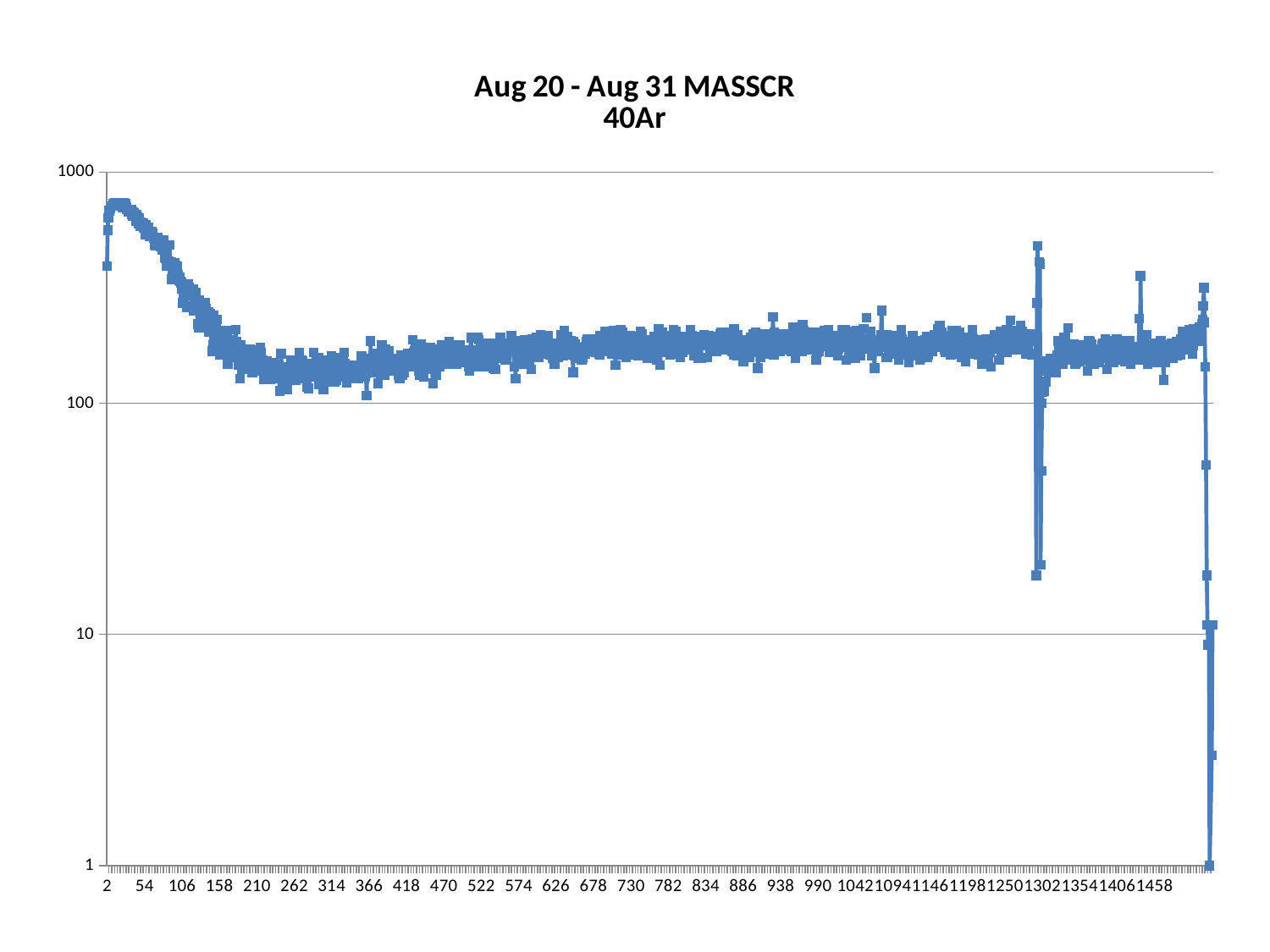
Between x = 54 and x = 210, do the values rise or fall? fall Is the value at x = 730 greater or less than 1000? less What is the title of the chart? Aug 20 - Aug 31 MASSCR 40Ar Is the value at x = 2 greater or less than 100? greater Which is larger, the value at x = 262 or the value at x = 54? x = 54 Is the value at x = 54 greater or less than 100? greater What is the highest tick label shown on the y axis? 1000 Which is larger, the value at x = 54 or the value at x = 730? x = 54 What kind of chart is shown on the slide? Line chart